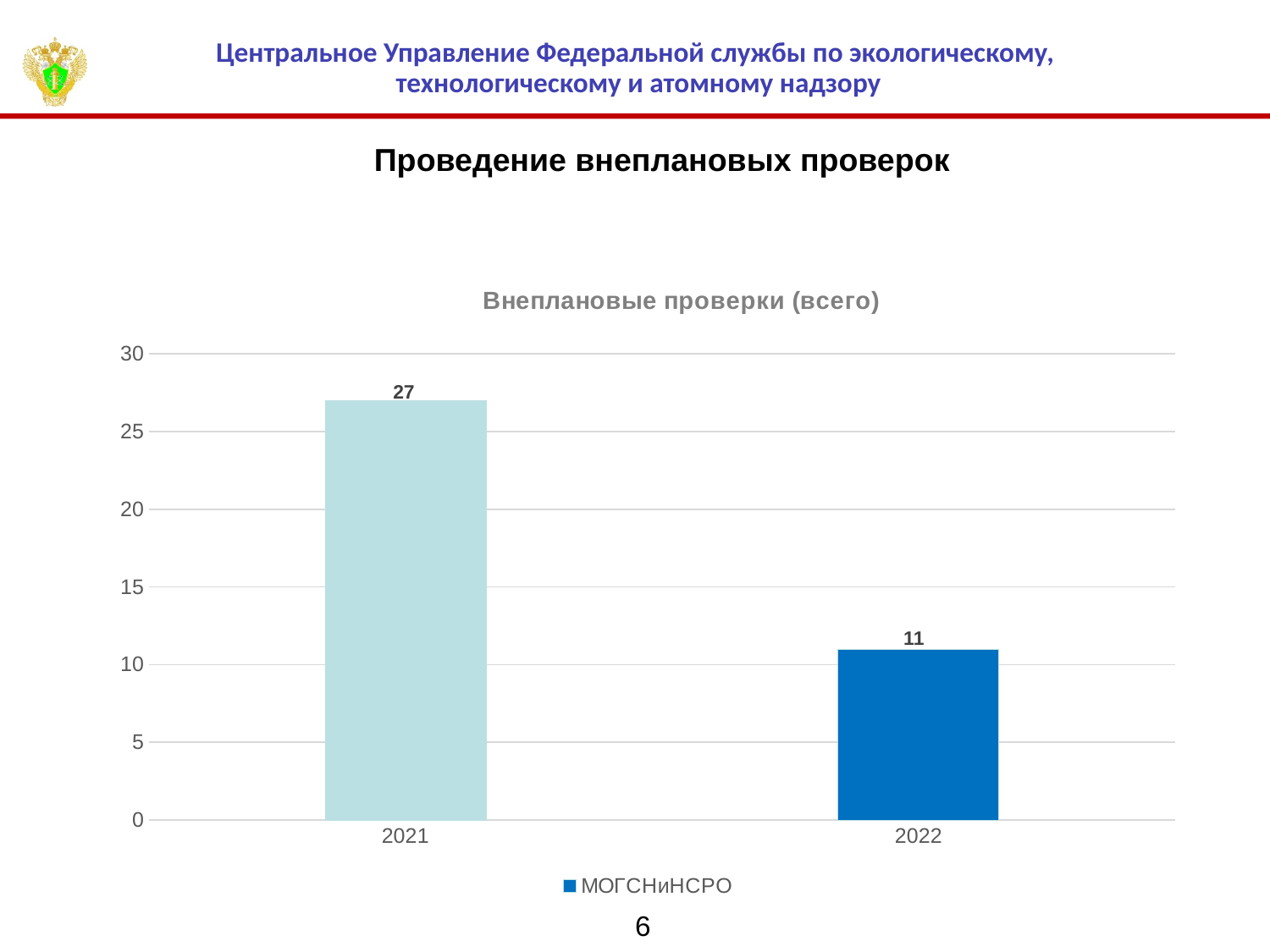
Is the value for 2022 greater or less than 15? less What is the value for 2022 in the chart? 11 How many categories are shown on the x axis? 2 What kind of chart is shown on the slide? bar chart Which year has the highest value? 2021 Is the value for 2021 greater or less than 25? greater Which year has the lowest value? 2022 What is the value for 2021 in the chart? 27 What is the difference between the values for 2021 and 2022? 16 Which is larger, the value for 2021 or the value for 2022? 2021 What is the title of the chart? Внеплановые проверки (всего) How many series does the legend list? 1